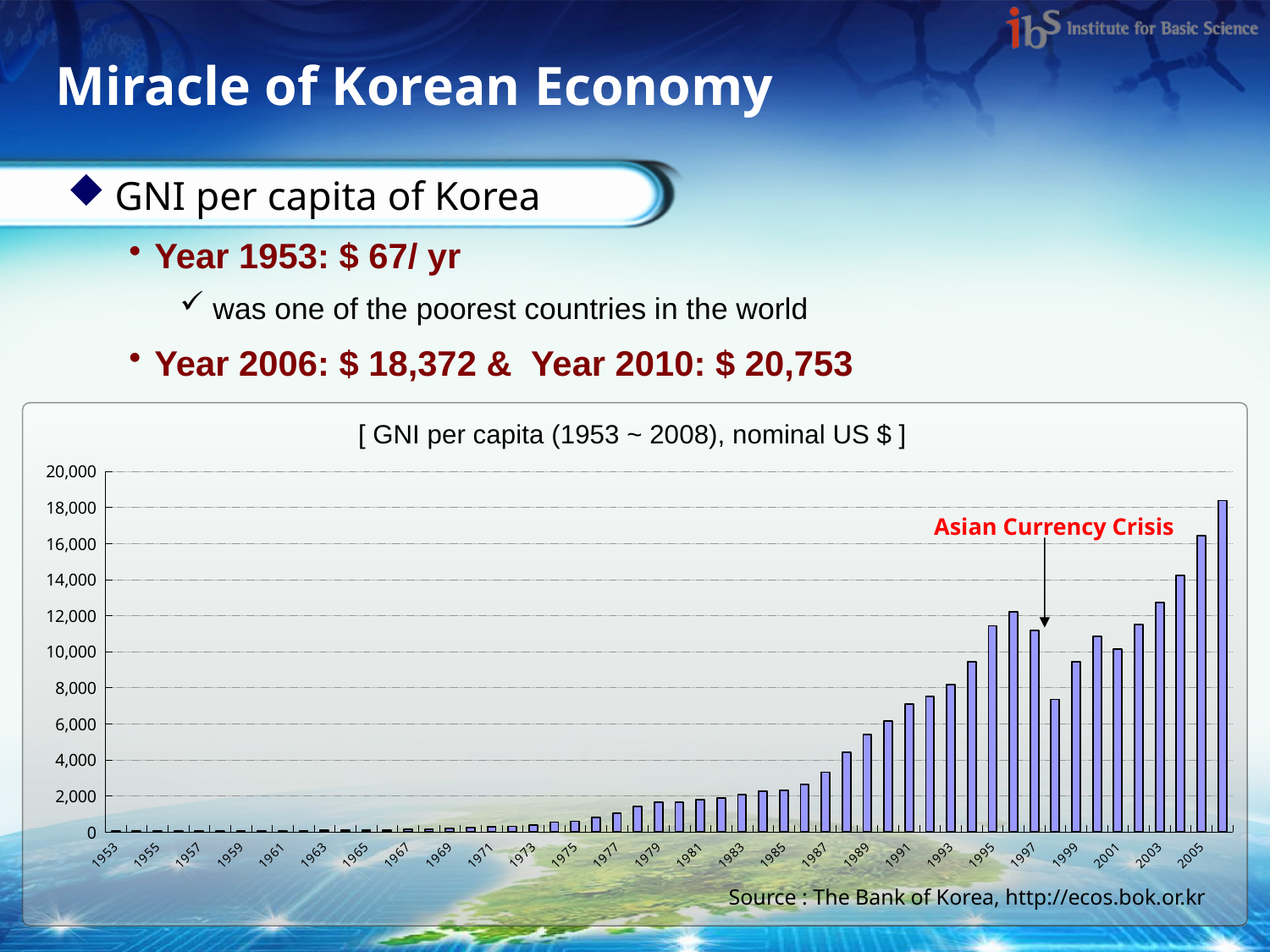
According to the slide text, what was Korea's GNI per capita in 1953? $ 67/ yr Is the value for 1998 greater or less than 8,000? less Which is larger, the value for 1997 or the value for 1998? 1997 What is the title of the chart? GNI per capita (1953 ~ 2008), nominal US $ Which event is annotated with an arrow on the chart? Asian Currency Crisis Is the value for 2003 greater or less than 12,000? greater Is the value for 1987 greater or less than 4,000? less What kind of chart is shown on the slide? bar chart Do the values generally rise or fall from 1953 to the end of the chart? rise Which is larger, the value for 1996 or the value for 1999? 1996